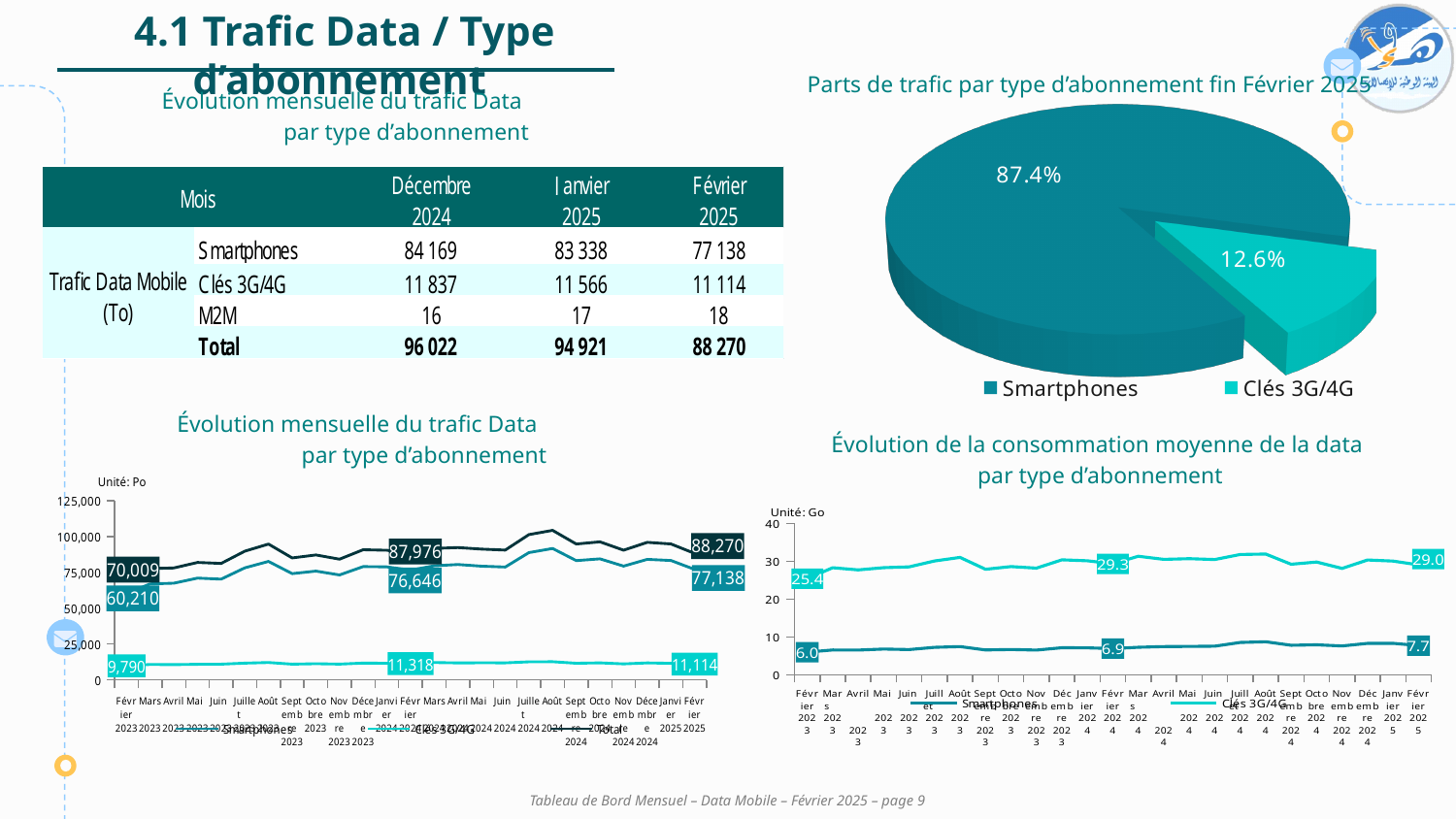
In the bottom-right chart 'Évolution de la consommation moyenne de la data par type d'abonnement', what is the labelled value of the Clés 3G/4G series for Février 2025? 29.0 In the bottom-right chart 'Évolution de la consommation moyenne de la data par type d'abonnement', which series has the higher value in Février 2025: Smartphones or Clés 3G/4G? Clés 3G/4G How many series does the legend of the bottom-left line chart 'Évolution mensuelle du trafic Data par type d'abonnement' list? 3 In the bottom-left line chart 'Évolution mensuelle du trafic Data par type d'abonnement', what is the labelled value of the Total series for Février 2025? 88,270 In the pie chart 'Parts de trafic par type d'abonnement fin Février 2025', which slice is the largest? Smartphones What kind of chart is the chart titled 'Parts de trafic par type d'abonnement fin Février 2025'? Pie chart In the bottom-left line chart 'Évolution mensuelle du trafic Data par type d'abonnement', what is the difference between the Total labels for Février 2025 (88,270) and Février 2023 (70,009)? 18,261 In the bottom-left line chart 'Évolution mensuelle du trafic Data par type d'abonnement', what is the labelled value of the Smartphones series for Février 2025? 77,138 How many entries does the legend of the pie chart 'Parts de trafic par type d'abonnement fin Février 2025' list? 2 In the pie chart 'Parts de trafic par type d'abonnement fin Février 2025', what share does Clés 3G/4G have? 12.6% In the pie chart 'Parts de trafic par type d'abonnement fin Février 2025', what share does Smartphones have? 87.4% In the bottom-left line chart 'Évolution mensuelle du trafic Data par type d'abonnement', what is the labelled value of the Clés 3G/4G series for Février 2023? 9,790